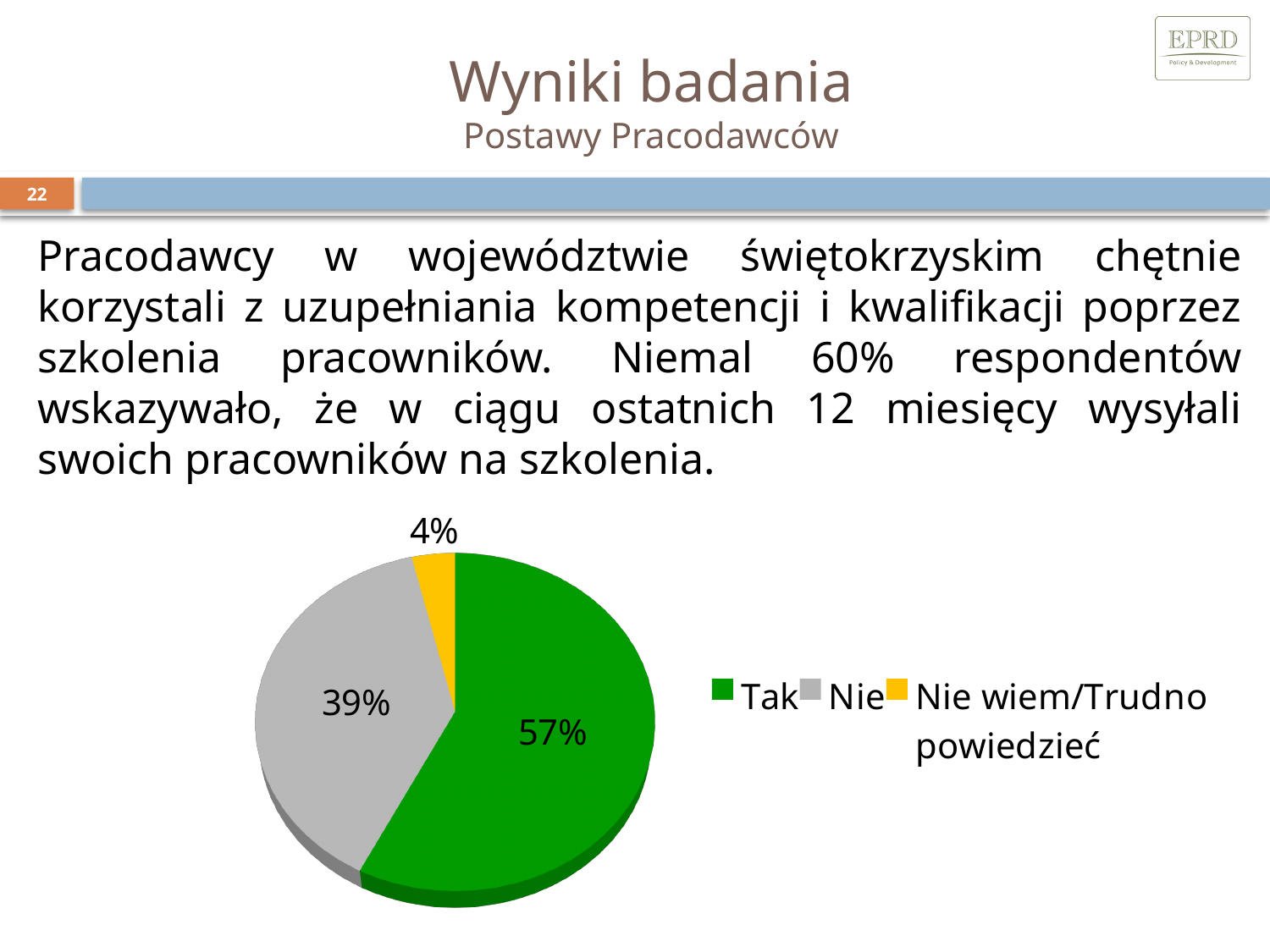
What is the difference between the "Tak" and "Nie" shares? 18% What colour is the "Nie wiem/Trudno powiedzieć" slice? yellow What share of the pie does "Nie wiem/Trudno powiedzieć" have? 4% What share of the pie does "Nie" have? 39% What colour is the "Tak" slice? green Which slice of the pie is the smallest? Nie wiem/Trudno powiedzieć What kind of chart is shown on the slide? pie chart Which is larger, the "Nie" share or the "Nie wiem/Trudno powiedzieć" share? Nie How many entries does the legend list? 3 How many slices does the pie chart have? 3 What share of the pie does "Tak" have? 57% Which slice of the pie is the largest? Tak